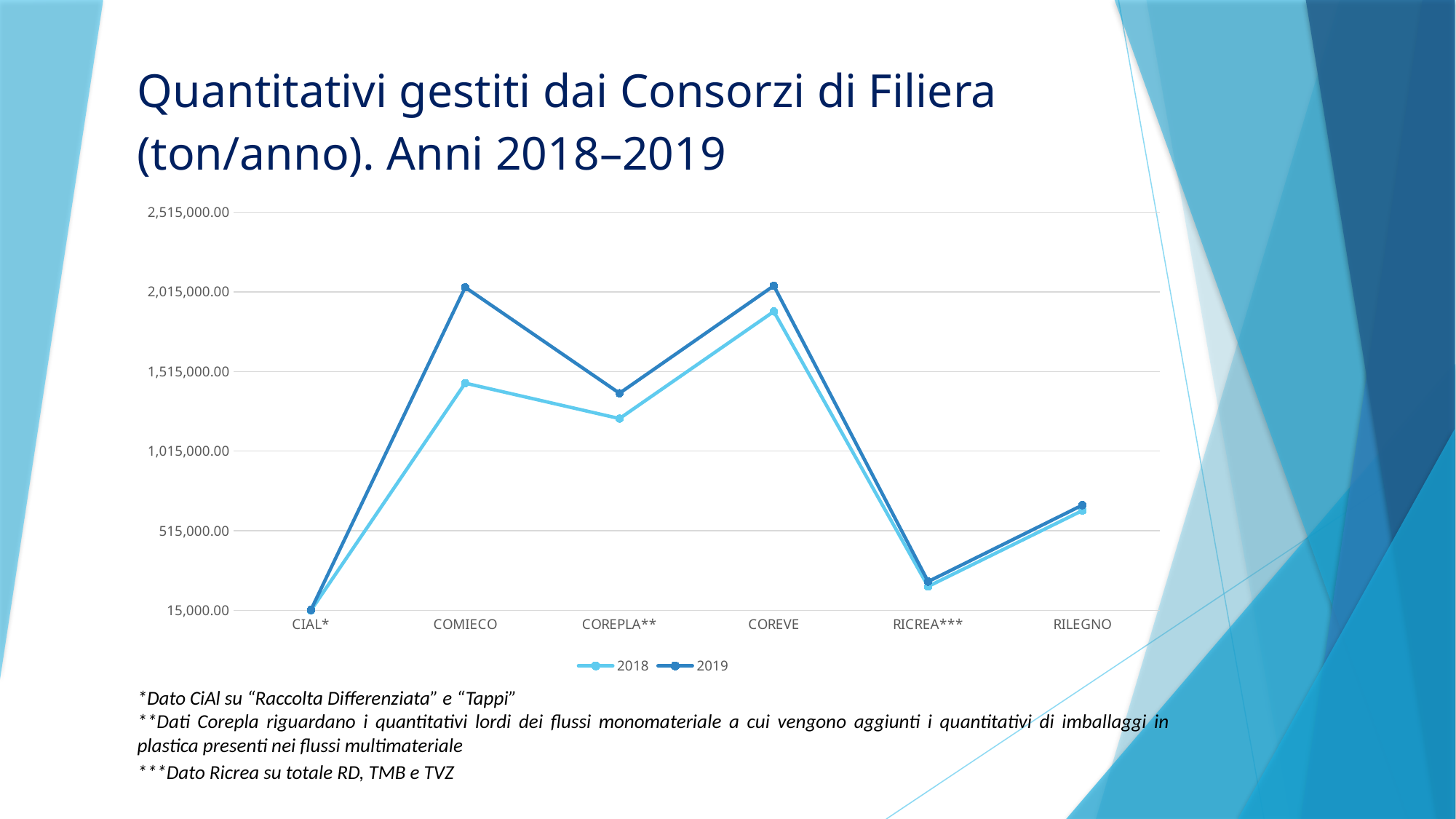
Is the 2018 value for COREVE greater or less than 1,515,000.00? greater For COMIECO, which series has the larger value, 2018 or 2019? 2019 How many series does the legend list? 2 Is the 2018 value for COMIECO greater or less than 1,515,000.00? less Which category has the lowest value for the 2019 series? CIAL* Is the 2019 value for COREPLA** greater or less than 1,515,000.00? less Which category has the highest value for the 2018 series? COREVE How many categories are shown on the x axis? 6 What are the two series named in the legend? 2018 and 2019 What kind of chart is shown on the slide? line chart